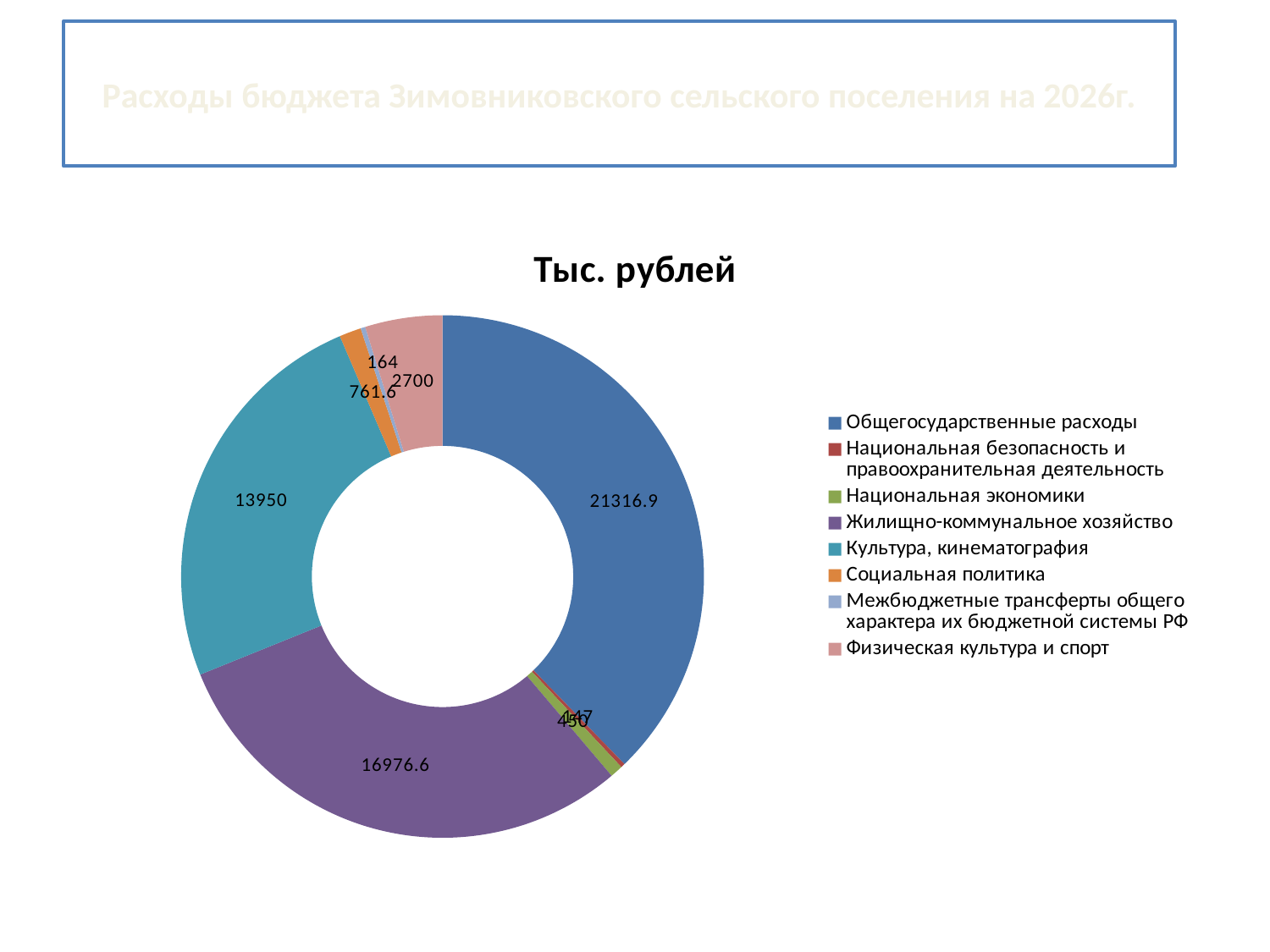
Which category has the largest value? Общегосударственные расходы What kind of chart is shown on the slide? Doughnut chart How many categories does the legend list? 8 Which is larger, Жилищно-коммунальное хозяйство or Культура, кинематография? Жилищно-коммунальное хозяйство What is the value for Культура, кинематография? 13950 What is the difference between Жилищно-коммунальное хозяйство and Культура, кинематография? 3026.6 What is the value for Физическая культура и спорт? 2700 What is the value for Общегосударственные расходы? 21316.9 What is the difference between Общегосударственные расходы and Жилищно-коммунальное хозяйство? 4340.3 What is the value for Социальная политика? 761.6 What is the title of the chart? Тыс. рублей What is the value for Жилищно-коммунальное хозяйство? 16976.6